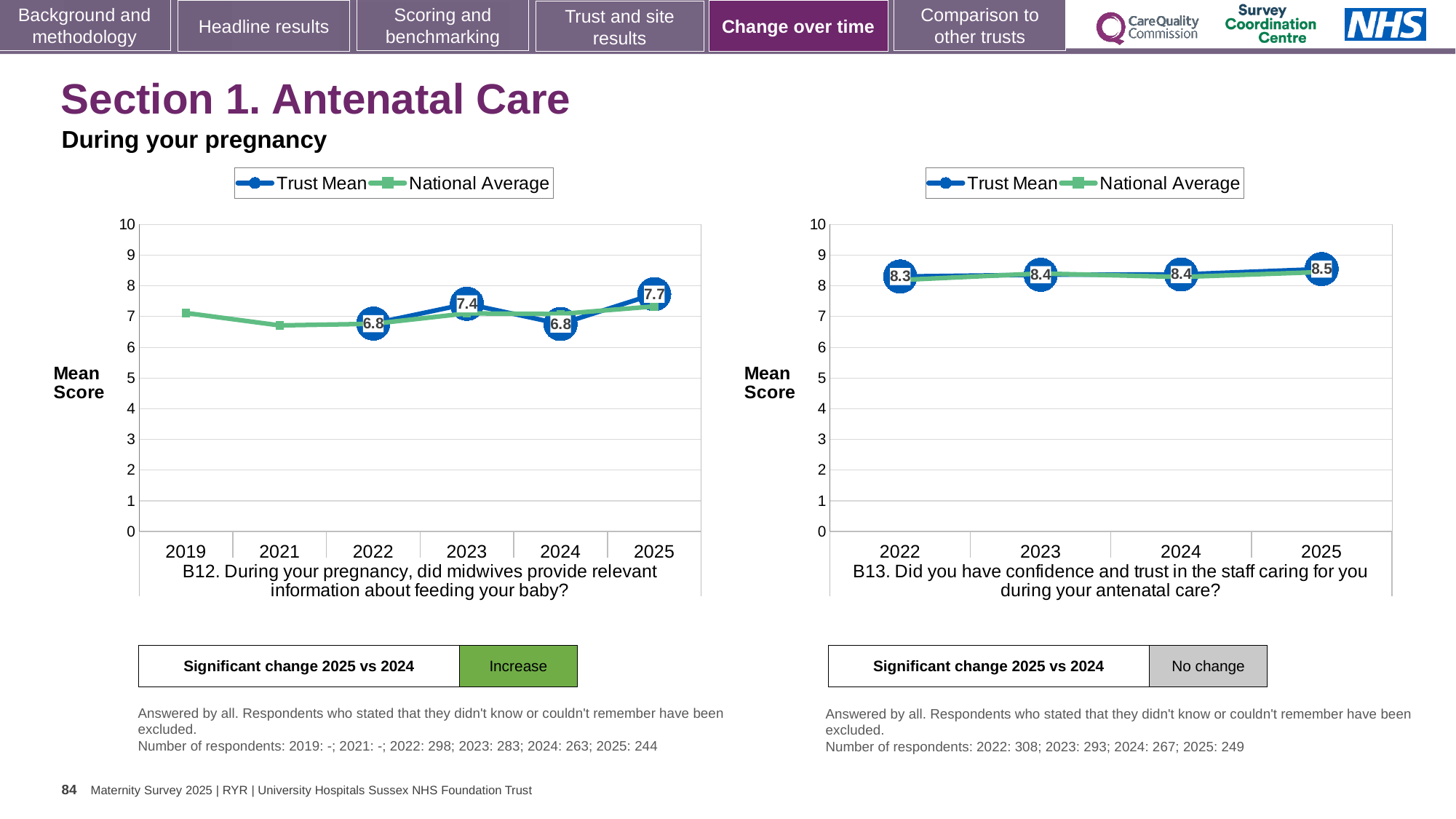
In the B12 chart (left), is the National Average for 2019 greater or less than 6? greater In the B13 chart (right), which year has the lowest Trust Mean? 2022 In the B13 chart (right), what is the Trust Mean for 2022? 8.3 In the B12 chart (left), what is the Trust Mean for 2025? 7.7 In the B12 chart (left), which year has the highest Trust Mean? 2025 In the B12 chart (left), what is the difference between the Trust Mean for 2025 and the Trust Mean for 2024? 0.9 In the B12 chart (left), is the Trust Mean higher in 2023 or in 2024? 2023 In the B13 chart (right), what is the Trust Mean for 2025? 8.5 How many series does the legend of the B13 chart (right) list? 2 In the B12 chart (left), what is the Trust Mean for 2023? 7.4 What type of chart is the B13 chart (right)? Line chart How many years are shown on the x axis of the B12 chart (left)? 6